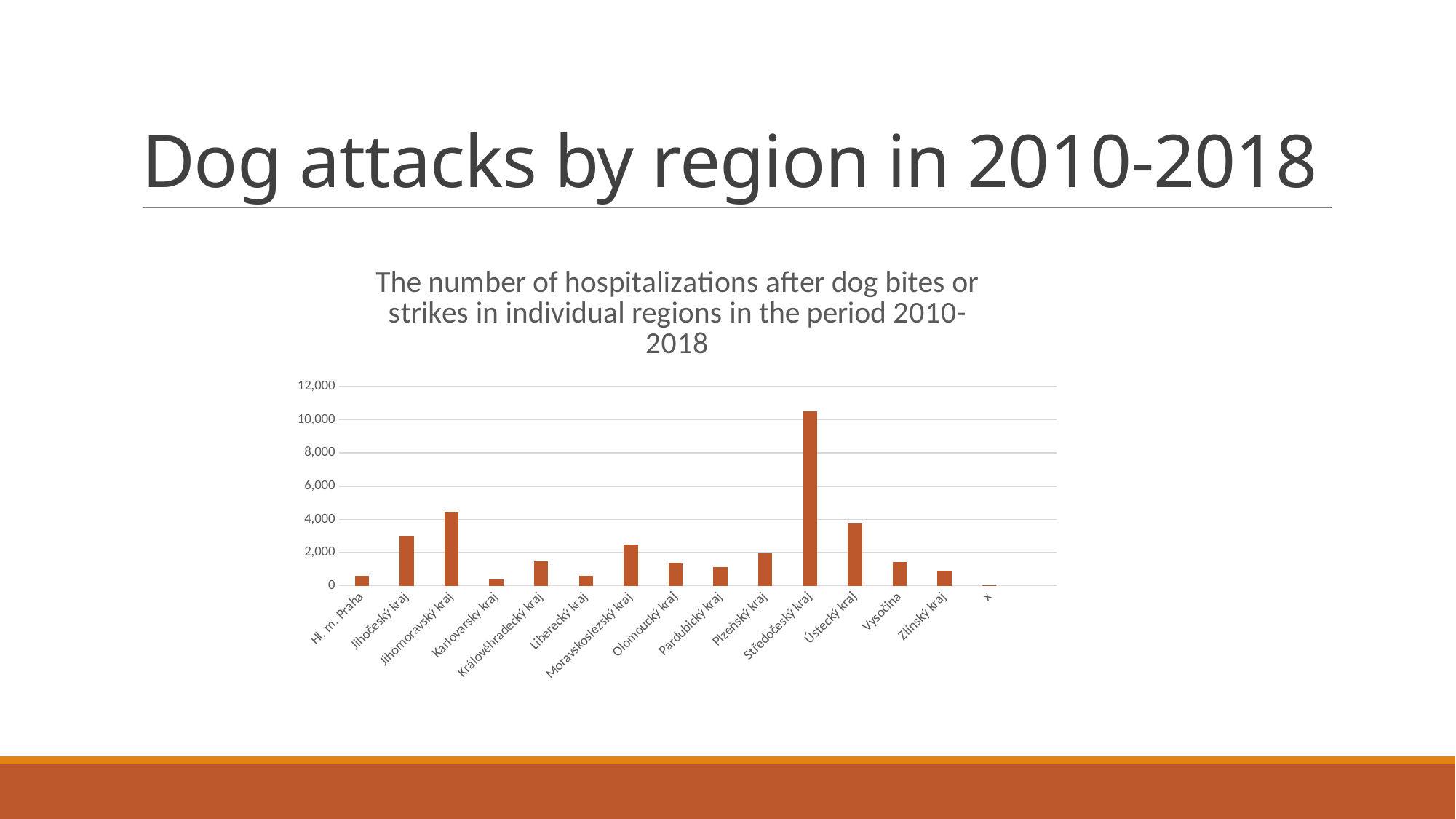
Is the value for Jihomoravský kraj greater or less than 4,000? greater What is the title of the chart? The number of hospitalizations after dog bites or strikes in individual regions in the period 2010-2018 Is the value for Ústecký kraj greater or less than 4,000? less Which has a higher value, Jihočeský kraj or Moravskoslezský kraj? Jihočeský kraj Is the value for Středočeský kraj greater or less than 10,000? greater What kind of chart is shown on the slide? bar chart Which has a higher value, Jihomoravský kraj or Ústecký kraj? Jihomoravský kraj Which category has the lowest bar in the chart? x How many categories are shown on the x axis of the chart? 15 Which region has the highest number of hospitalizations in the chart? Středočeský kraj